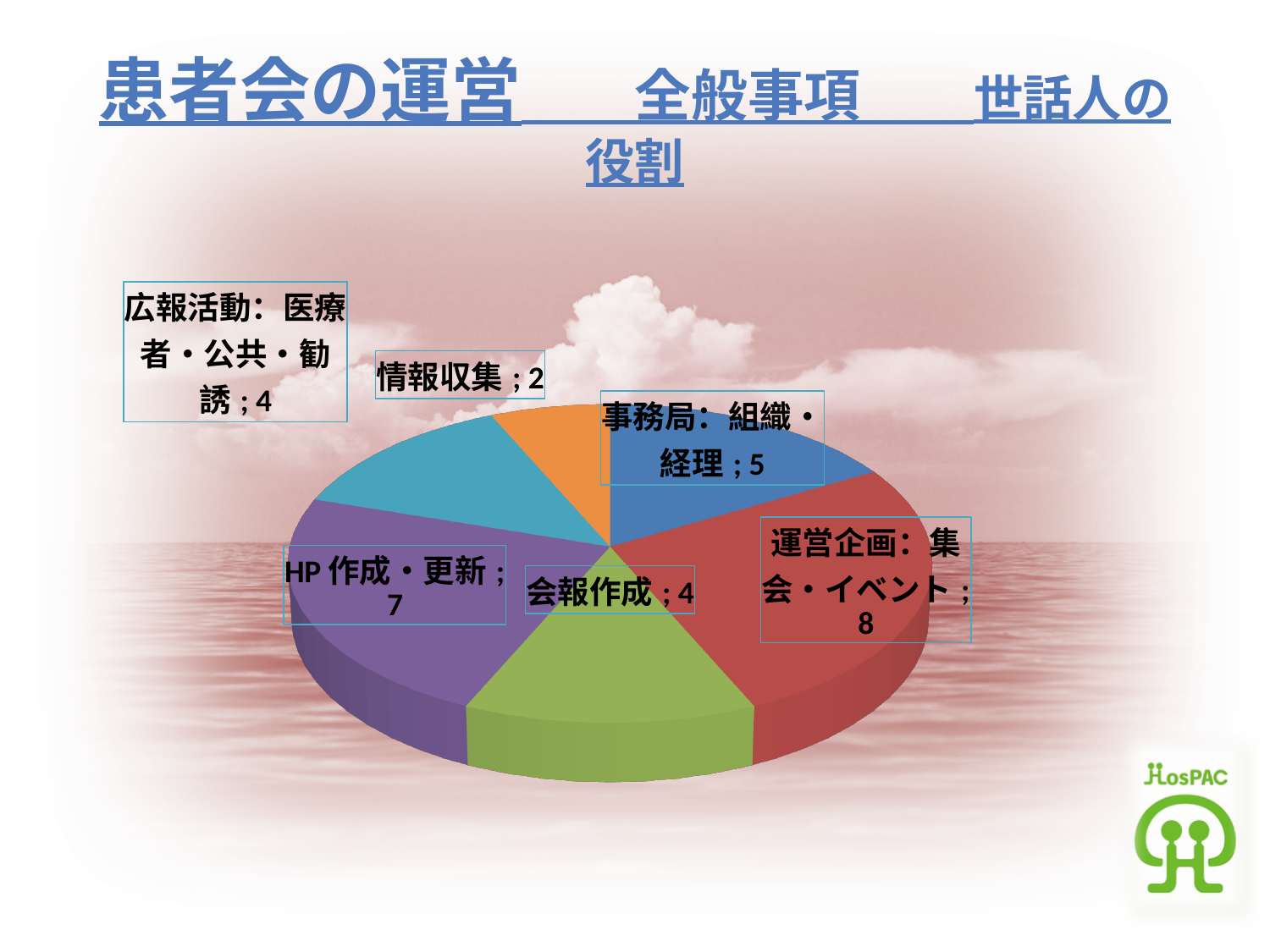
What is the total of all the values in the pie chart? 30 What colour is the slice for 会報作成? Green Which category has the largest slice? 運営企画：集会・イベント What is the value for 情報収集? 2 What is the difference between the values for 運営企画：集会・イベント and HP作成・更新? 1 What is the value for 運営企画：集会・イベント? 8 Which is larger, the value for 事務局：組織・経理 or the value for 会報作成? 事務局：組織・経理 What is the value for HP作成・更新? 7 What kind of chart is shown on the slide? Pie chart What is the value for 事務局：組織・経理? 5 Which category has the smallest slice? 情報収集 How many slices does the pie chart have? 6